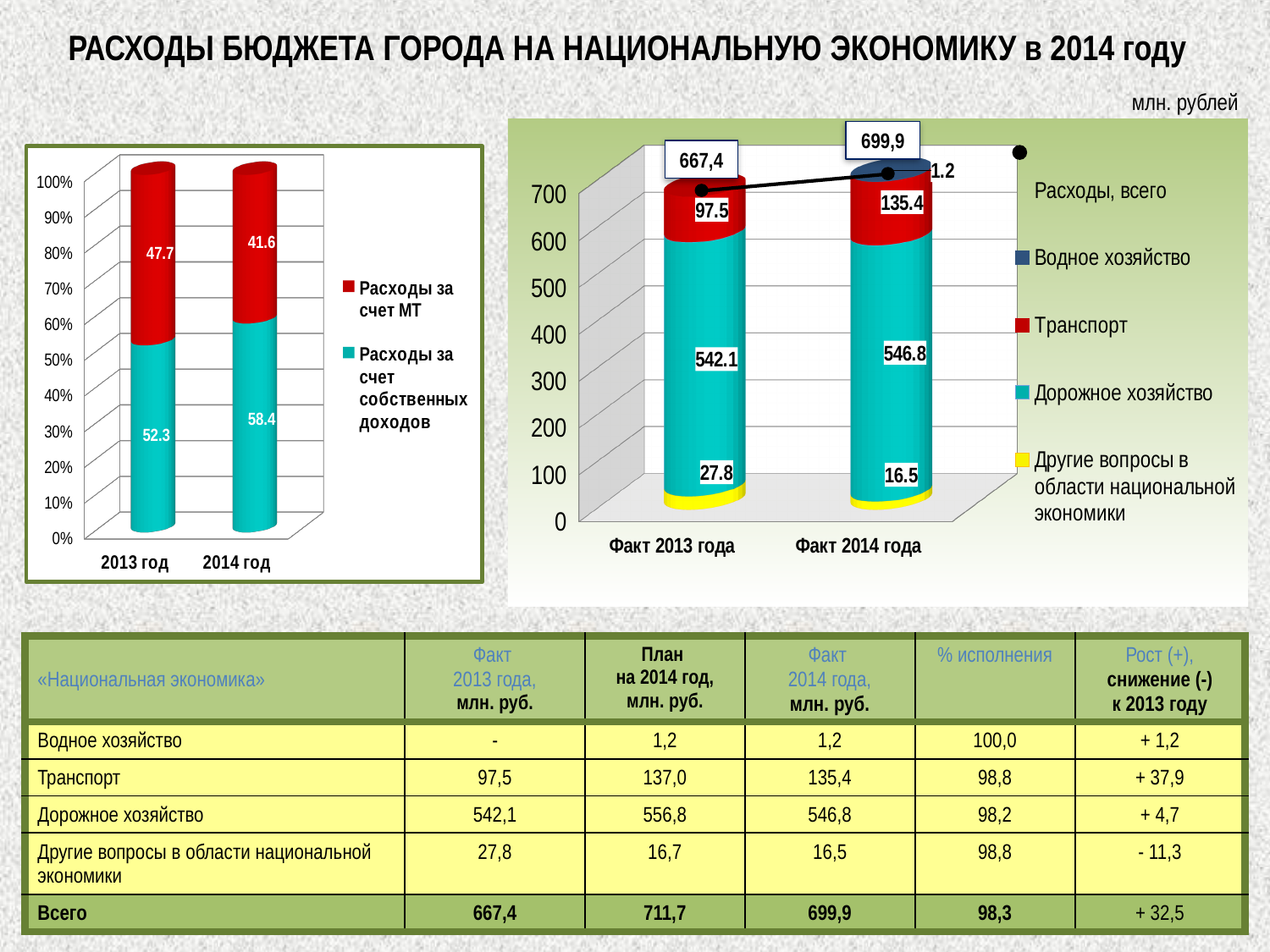
In the right chart, what is the value of «Дорожное хозяйство» for Факт 2014 года? 546.8 In the left chart, what is the value of «Расходы за счет собственных доходов» for 2014 год? 58.4 In the right chart, what is the value of «Транспорт» for Факт 2013 года? 97.5 What kind of chart is the right chart? stacked bar chart with a line In the right chart, which category has the larger value for «Другие вопросы в области национальной экономики», Факт 2013 года or Факт 2014 года? Факт 2013 года In the left chart, does the share of «Расходы за счет МТ» rise or fall from 2013 год to 2014 год? fall In the right chart, what is the difference between «Транспорт» in Факт 2014 года and Факт 2013 года? 37.9 In the right chart, what is the value of «Расходы, всего» for Факт 2014 года? 699,9 In the left chart, what is the value of «Расходы за счет МТ» for 2013 год? 47.7 In the left chart, how many series does the legend list? 2 In the right chart, how many entries does the legend list? 5